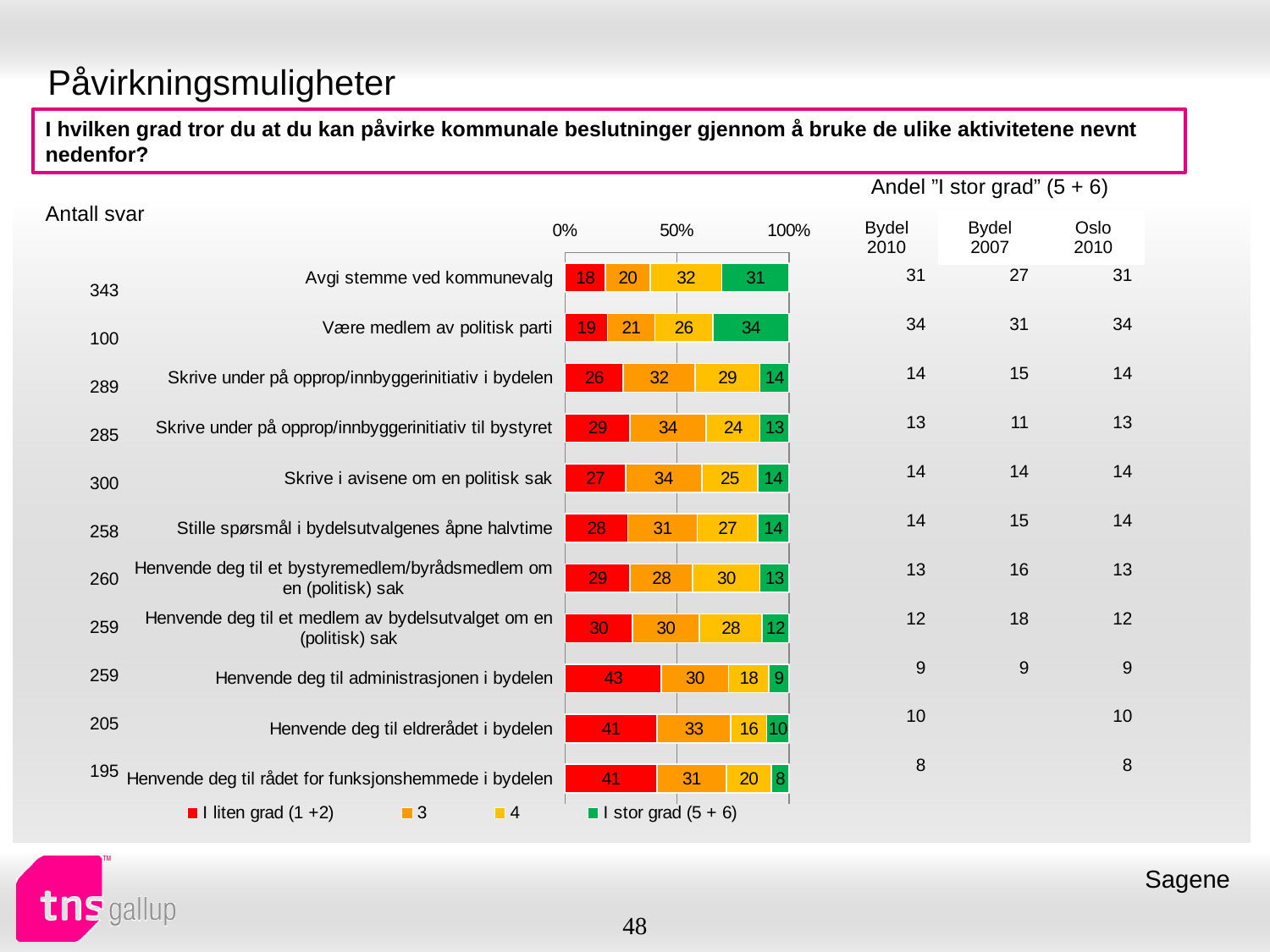
What is the total of the stacked bar for "Henvende deg til administrasjonen i bydelen"? 100 Which activity has the largest "I liten grad (1 +2)" segment? Henvende deg til administrasjonen i bydelen How many series does the chart legend list? 4 What percentage answered "I stor grad (5 + 6)" for "Avgi stemme ved kommunevalg"? 31 How many activities (categories) are shown in the bar chart? 11 What is the "I liten grad (1 +2)" value for "Henvende deg til administrasjonen i bydelen"? 43 Which activity has the lowest "I stor grad (5 + 6)" share? Henvende deg til rådet for funksjonshemmede i bydelen Which activity has the highest "I stor grad (5 + 6)" share? Være medlem av politisk parti Which has a larger "I liten grad (1 +2)" value: "Henvende deg til eldrerådet i bydelen" or "Skrive i avisene om en politisk sak"? Henvende deg til eldrerådet i bydelen What is the difference between the "I stor grad (5 + 6)" values for "Være medlem av politisk parti" and "Avgi stemme ved kommunevalg"? 3 What is the value of the "4" segment for "Skrive under på opprop/innbyggerinitiativ i bydelen"? 29 What kind of chart is used on this slide? Stacked bar chart